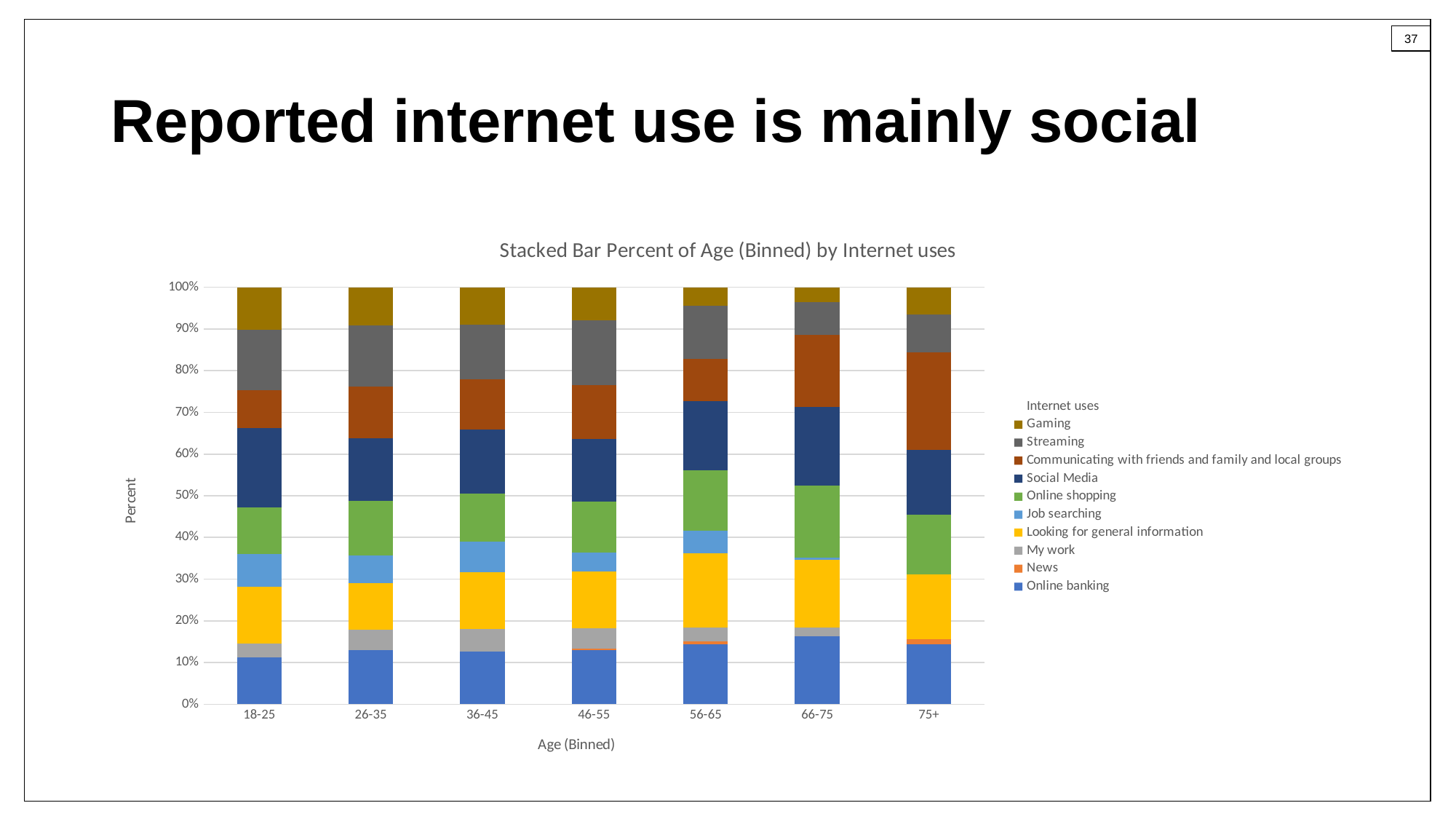
What is the total of the stacked bar for the 18-25 age group? 100% What kind of chart is shown on the slide? Stacked bar chart Is the Online banking share for the 56-65 age group greater or less than 20%? less How many age groups are shown on the x axis of the chart? 7 What is the title of the chart? Stacked Bar Percent of Age (Binned) by Internet uses What is the label on the x axis of the chart? Age (Binned) Which age group has the larger Communicating with friends and family and local groups share, 18-25 or 75+? 75+ How many internet uses does the chart legend list? 10 Is the Online banking share for the 66-75 age group greater or less than 10%? greater Which age group has the larger Gaming share, 18-25 or 66-75? 18-25 Which age group has the largest Communicating with friends and family and local groups share? 75+ Which age group has the larger Online banking share, 18-25 or 66-75? 66-75